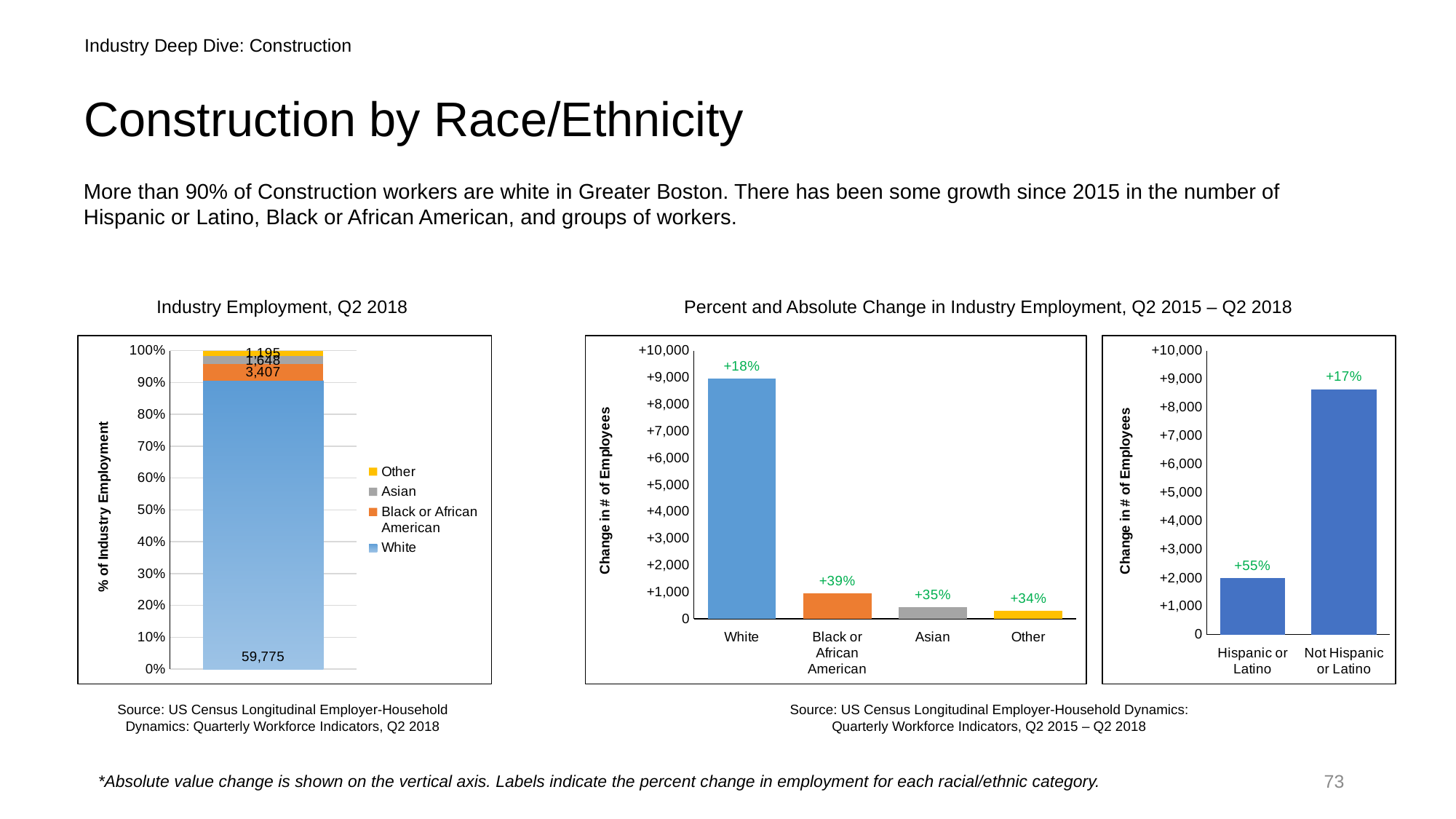
In the middle chart showing change in industry employment by race, which category has the largest absolute change in number of employees? White In the 'Industry Employment, Q2 2018' chart on the left, what is the difference between the values for Black or African American and Asian? 1,759 In the 'Industry Employment, Q2 2018' chart on the left, how many series does the legend list? 4 In the middle chart showing change in industry employment by race, is the absolute change for White greater or less than +8,000? greater In the 'Industry Employment, Q2 2018' chart on the left, what is the total of the stacked bar? 66,025 In the rightmost chart showing change in industry employment by Hispanic or Latino status, which category has the larger absolute change in number of employees? Not Hispanic or Latino In the middle chart showing change in industry employment by race, how many categories are shown on the x axis? 4 In the rightmost chart showing change in industry employment by Hispanic or Latino status, what percent change label is shown for Hispanic or Latino? +55% In the middle chart showing change in industry employment by race, what percent change label is shown for Black or African American? +39% In the 'Industry Employment, Q2 2018' chart on the left, what is the value shown for White? 59,775 In the 'Industry Employment, Q2 2018' chart on the left, what is the value shown for Asian? 1,648 What kind of chart is the 'Industry Employment, Q2 2018' chart on the left? Stacked bar chart